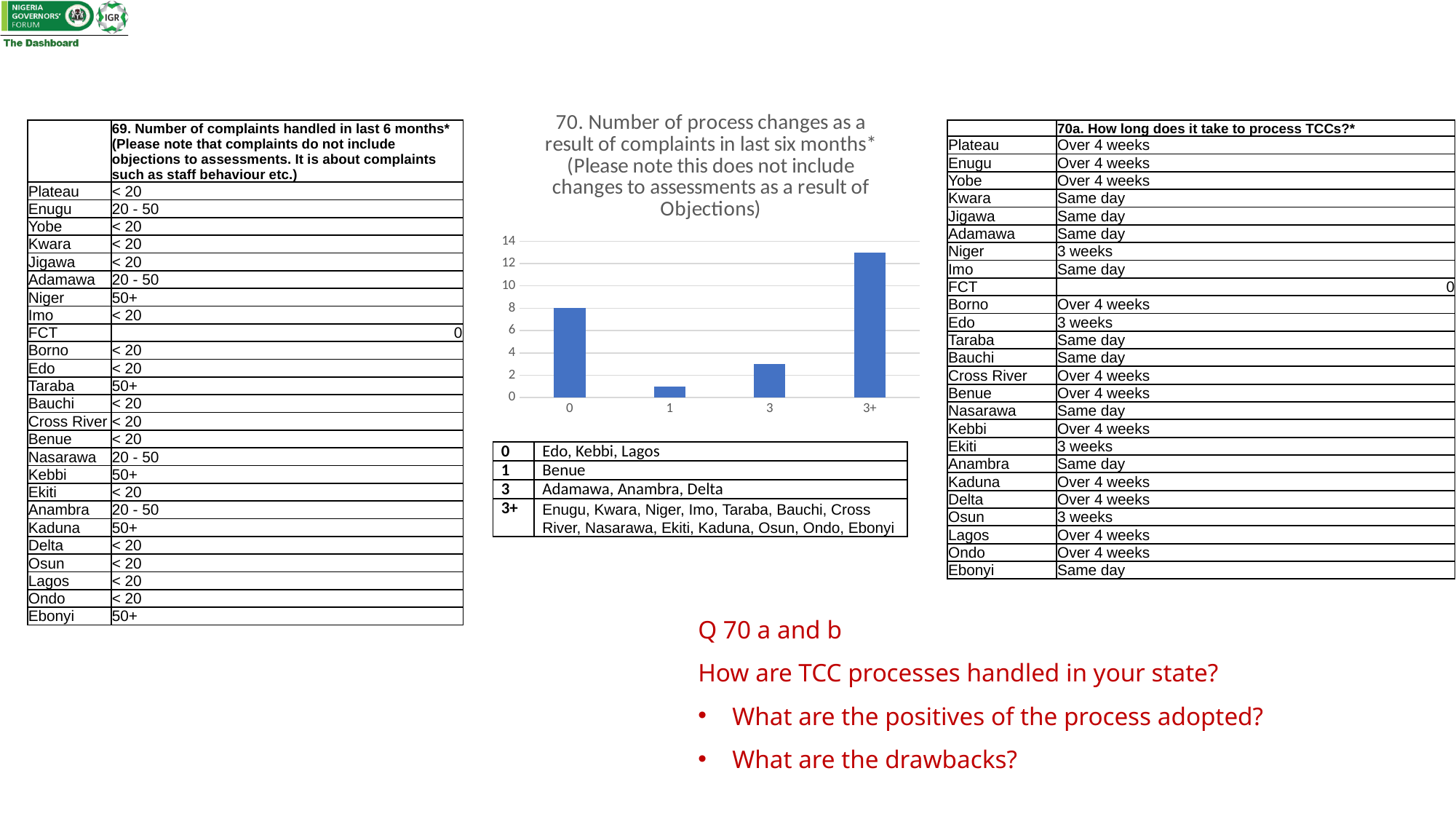
Which bar is taller, the one for category 3 or the one for category 1? 3 Which bar is taller, the one for category 0 or the one for category 3? 0 What is the value of the bar for category 0 in the chart? 8 Which category has the shortest bar in the chart? 1 Is the value for category 3+ greater or less than 12? greater What is the highest value shown on the chart's vertical axis? 14 What question number does the chart title refer to? 70 Is the value for category 3 greater or less than 4? less Is the value for category 1 greater or less than 2? less Which category has the tallest bar in the chart? 3+ How many categories are shown on the x axis of the chart? 4 What kind of chart is used to show the number of process changes as a result of complaints? bar chart